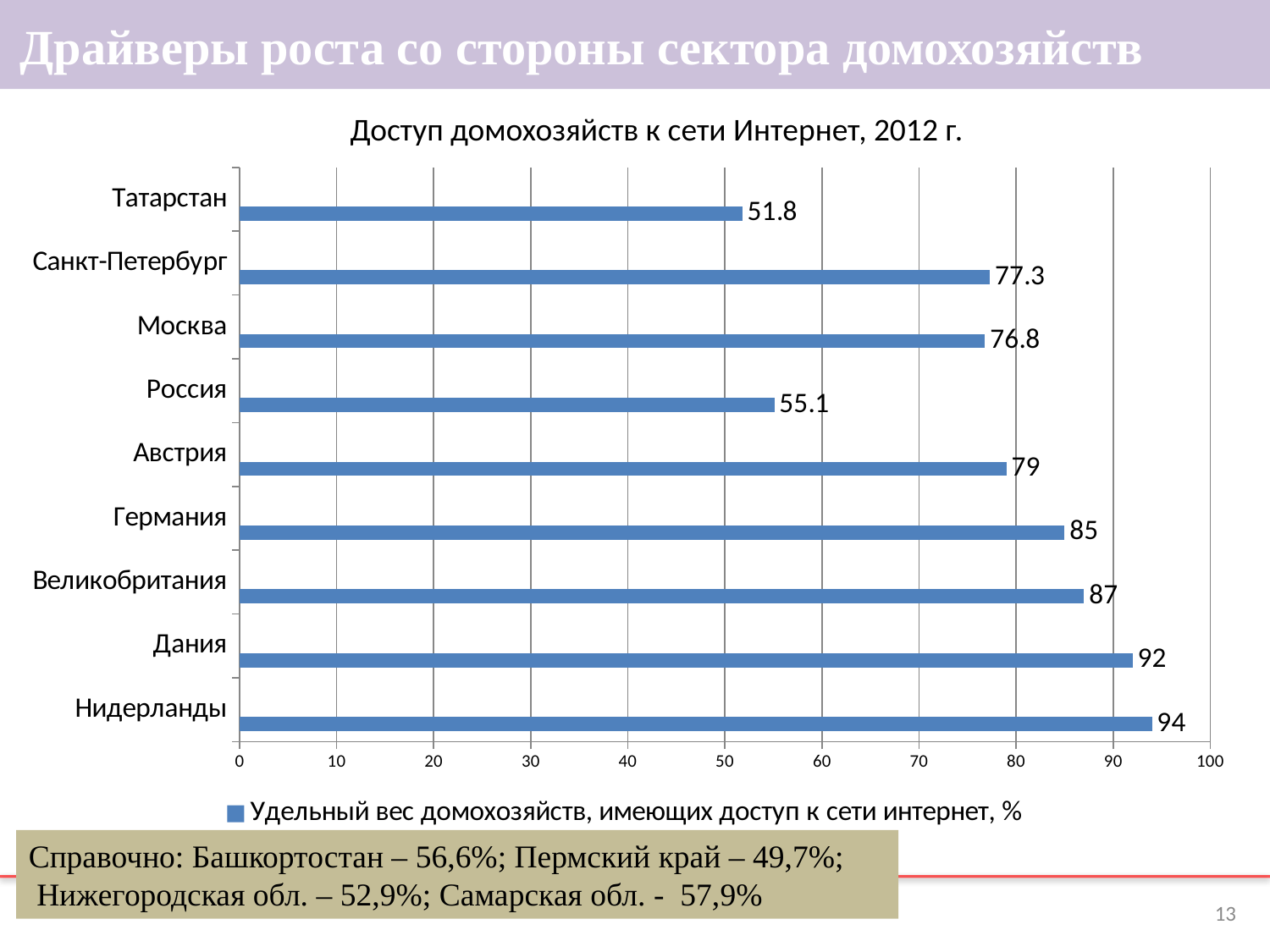
Which category has the lowest value? Татарстан What kind of chart is shown on the slide? bar chart What is the value for Германия? 85 What is the difference between the values for Санкт-Петербург and Татарстан? 25.5 Which category has the highest value? Нидерланды What is the value for Татарстан? 51.8 What is the title of the chart? Доступ домохозяйств к сети Интернет, 2012 г. Is the value for Великобритания greater or less than 80? greater How many categories are shown in the chart? 9 What is the value for Россия? 55.1 Which is larger, the value for Австрия or the value for Москва? Австрия What is the difference between the values for Нидерланды and Дания? 2